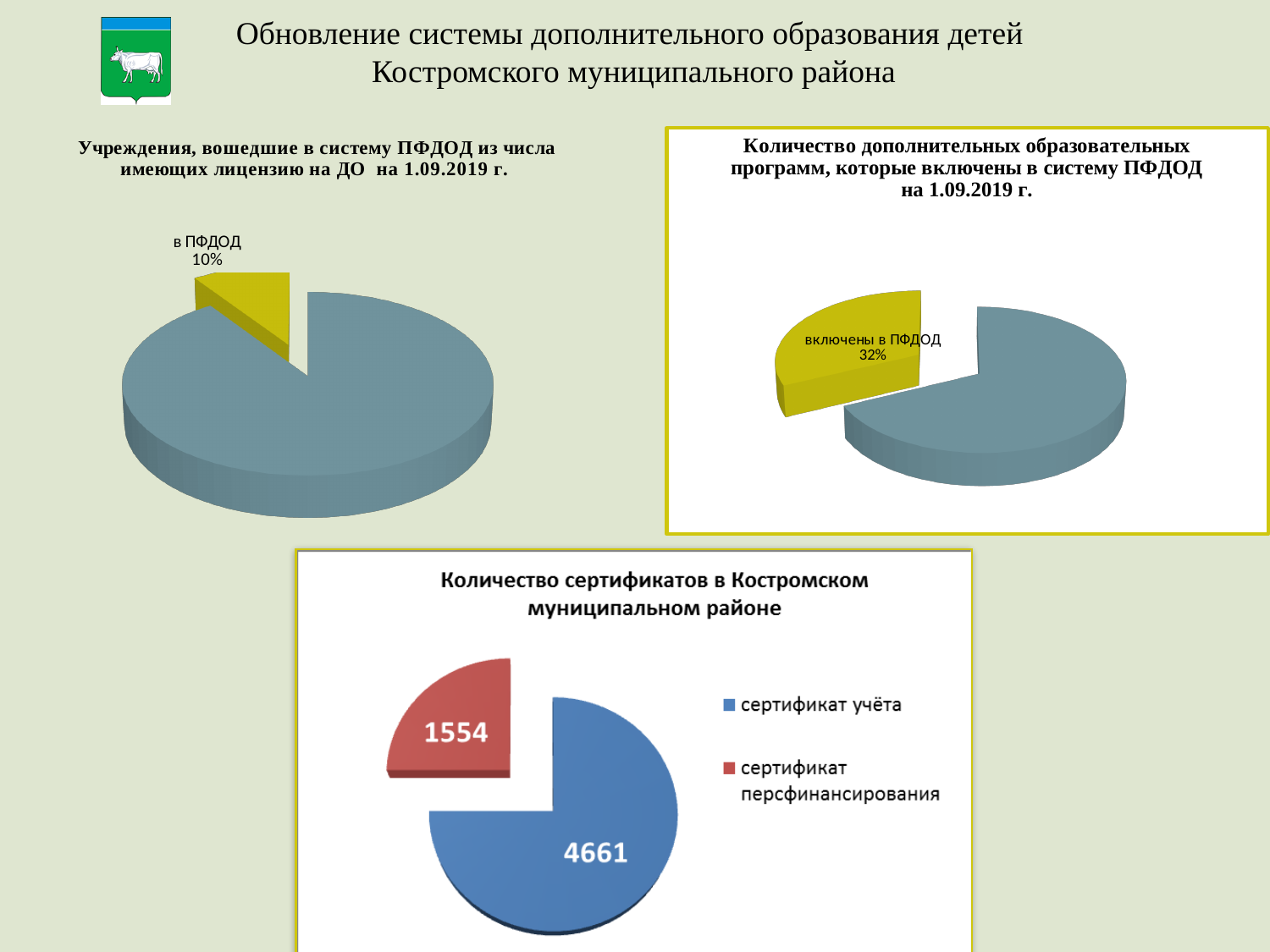
In the bottom chart 'Количество сертификатов в Костромском муниципальном районе', what is the value for 'сертификат персфинансирования'? 1554 In the bottom chart 'Количество сертификатов в Костромском муниципальном районе', what is the difference between 'сертификат учёта' and 'сертификат персфинансирования'? 3107 In the bottom chart 'Количество сертификатов в Костромском муниципальном районе', what colour is the slice for 'сертификат персфинансирования'? Red In the bottom chart 'Количество сертификатов в Костромском муниципальном районе', what is the value for 'сертификат учёта'? 4661 What kind of chart is the top-right chart 'Количество дополнительных образовательных программ'? Pie chart In the top-right chart 'Количество дополнительных образовательных программ, которые включены в систему ПФДОД на 1.09.2019 г.', what share is labelled 'включены в ПФДОД'? 32% In the top-left chart 'Учреждения, вошедшие в систему ПФДОД из числа имеющих лицензию на ДО на 1.09.2019 г.', what share is labelled 'в ПФДОД'? 10% In the bottom chart 'Количество сертификатов в Костромском муниципальном районе', what is the total of the two slices? 6215 What kind of chart is the top-left chart 'Учреждения, вошедшие в систему ПФДОД'? Pie chart How many entries does the legend of the bottom chart 'Количество сертификатов в Костромском муниципальном районе' list? 2 In the bottom chart 'Количество сертификатов в Костромском муниципальном районе', which category has the larger value? сертификат учёта In the bottom chart 'Количество сертификатов в Костромском муниципальном районе', which category has the smaller value? сертификат персфинансирования